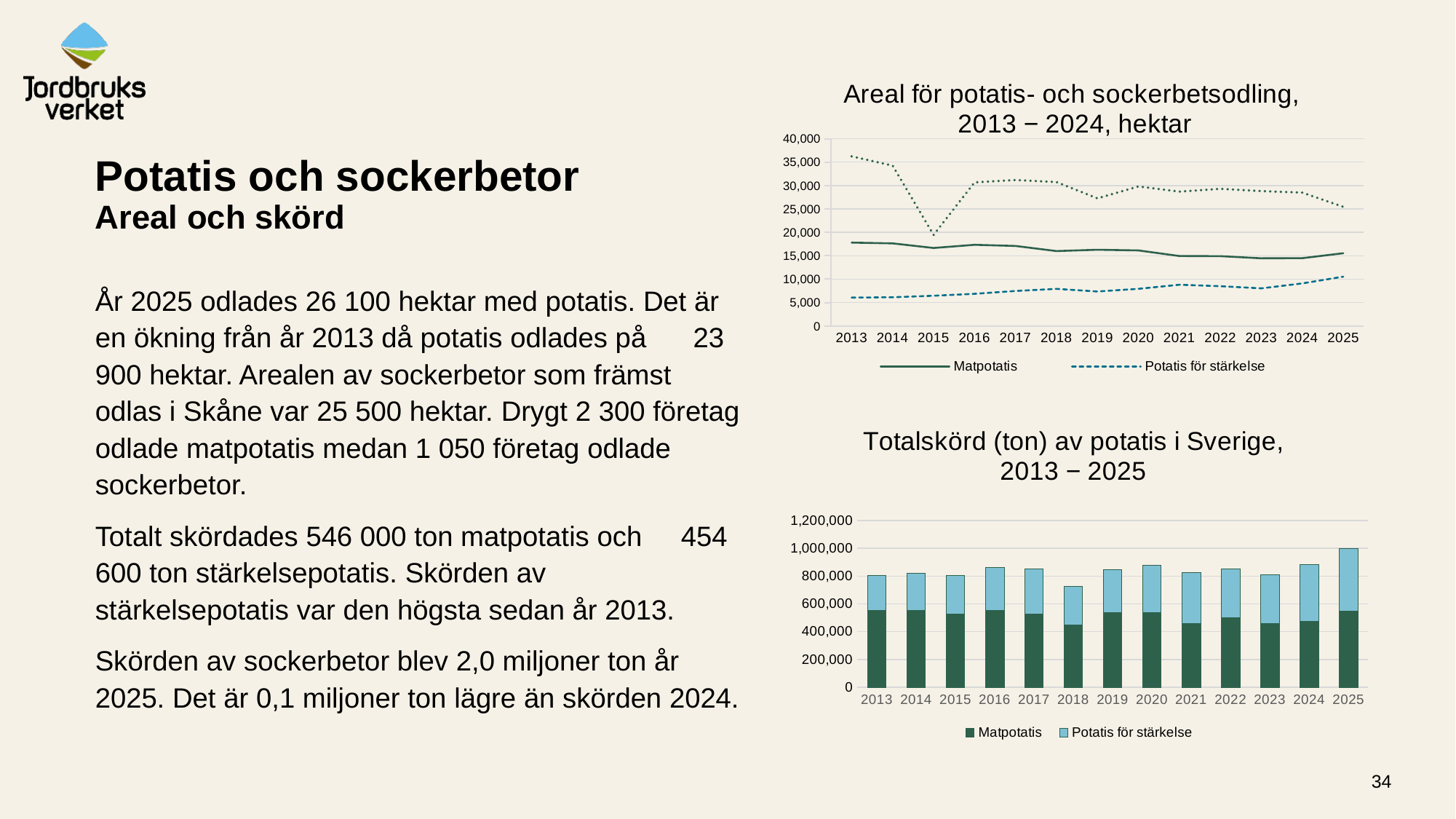
In the bottom chart, which year has the lowest total harvest? 2018 What kind of chart is the top chart, 'Areal för potatis- och sockerbetsodling, 2013 − 2024, hektar'? line chart In the top chart, which is larger in 2013: Matpotatis or Potatis för stärkelse? Matpotatis In the bottom chart, how many series does the legend list? 2 What kind of chart is the bottom chart, 'Totalskörd (ton) av potatis i Sverige, 2013 − 2025'? bar chart In the top chart, is the value for Potatis för stärkelse in 2013 greater or less than 10,000? less In the top chart, how many series does the legend list? 2 In the top chart, does the Potatis för stärkelse line generally rise or fall from 2013 to 2025? rise In the top chart, is the value for Matpotatis in 2013 greater or less than 15,000? greater In the bottom chart, which year has the highest total harvest? 2025 In the bottom chart, how many years are shown on the x axis? 13 In the bottom chart, is the total for 2018 greater or less than 800,000? less